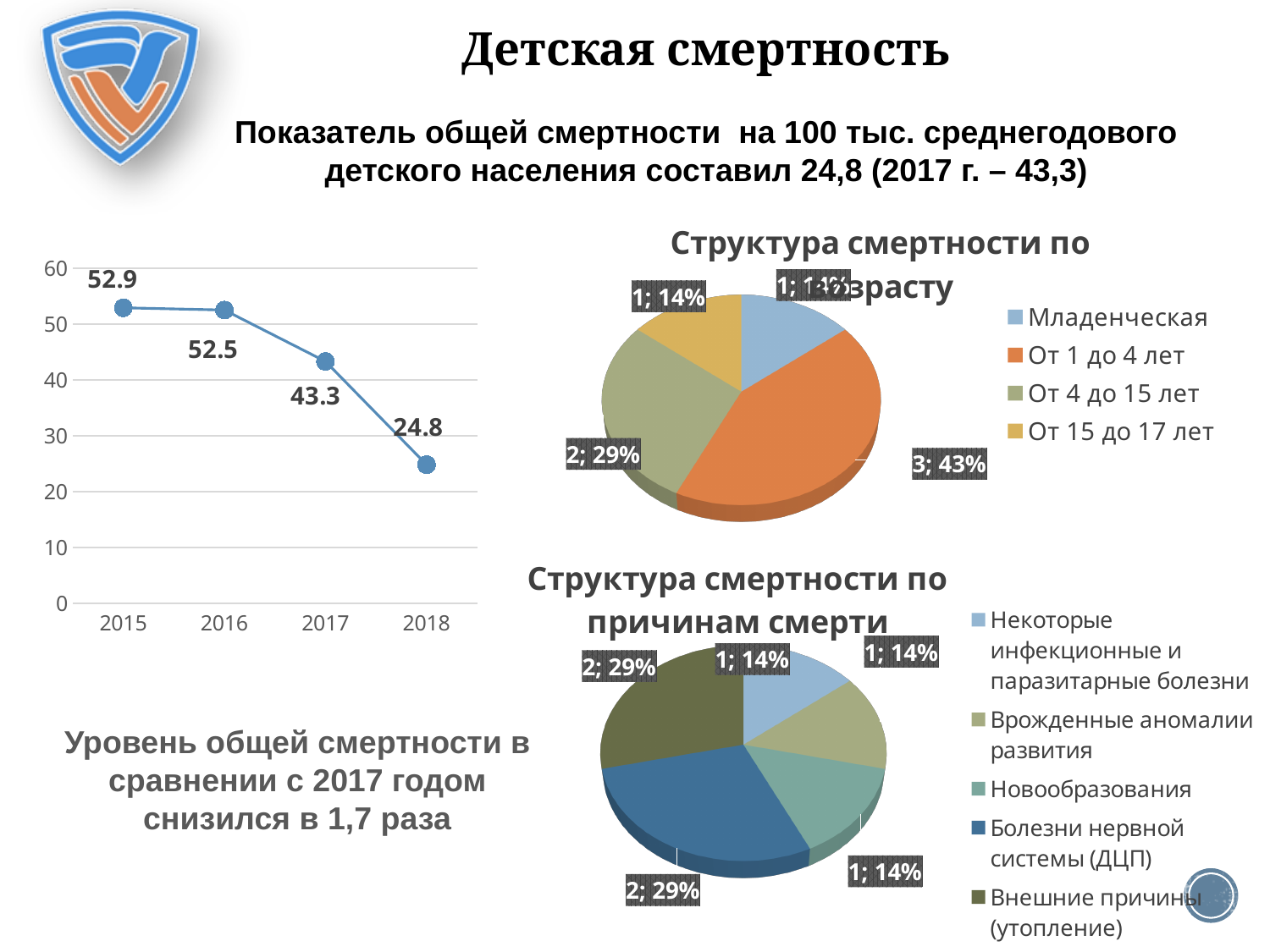
On the line chart on the left, what is the difference between the 2017 and 2018 values? 18.5 On the pie chart 'Структура смертности по возрасту', which category has the largest share? От 1 до 4 лет On the line chart on the left, what is the value for 2018? 24.8 On the line chart on the left, which year has the lowest value? 2018 On the pie chart 'Структура смертности по причинам смерти', how many categories does the legend list? 5 On the line chart on the left, what is the value for 2015? 52.9 On the line chart on the left, which year has the highest value? 2015 On the line chart on the left, how many years are plotted? 4 On the line chart on the left, do the values rise or fall from 2015 to 2018? fall On the line chart on the left, what is the value for 2017? 43.3 On the pie chart 'Структура смертности по возрасту', what share does 'От 1 до 4 лет' have? 43% On the pie chart 'Структура смертности по причинам смерти', what share does 'Болезни нервной системы (ДЦП)' have? 29%